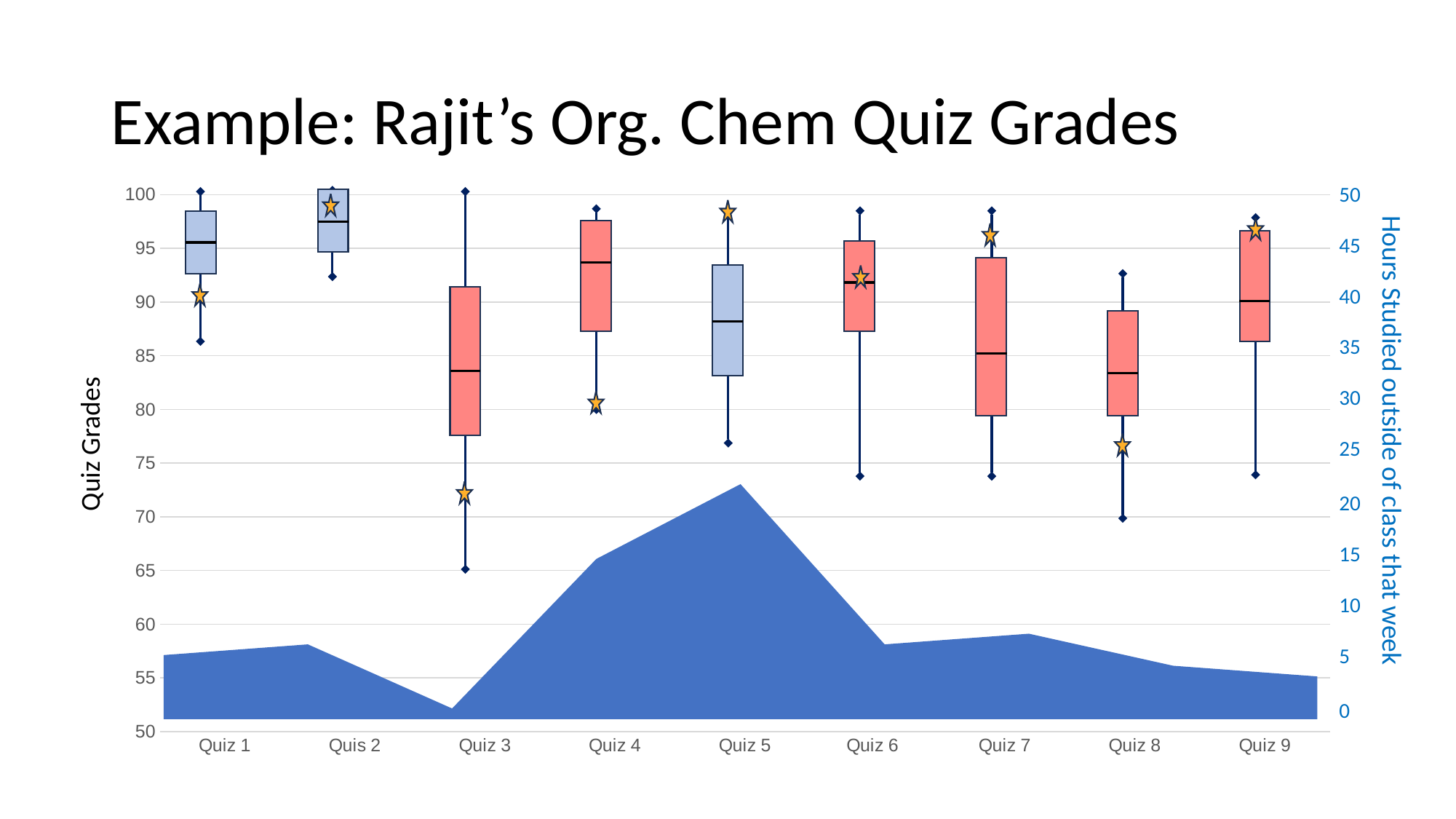
What is the title of the chart on the slide? Example: Rajit's Org. Chem Quiz Grades Which quiz has the lowest star marker on the Quiz Grades axis? Quiz 3 How many quizzes are shown along the x axis? 9 Is the star marker for Quiz 5 greater or less than 95 on the Quiz Grades axis? greater Do the hours studied rise or fall from Quiz 5 to Quiz 9? fall What kind of chart is shown on the slide? A box-and-whisker chart combined with an area chart Is the hours-studied value for Quiz 5 greater or less than 20? greater Is the hours-studied value for Quiz 3 greater or less than 5? less Which quiz has the lowest value in the blue area series (hours studied)? Quiz 3 What is the title of the right-hand vertical axis? Hours Studied outside of class that week Which quiz has the highest value in the blue area series (hours studied)? Quiz 5